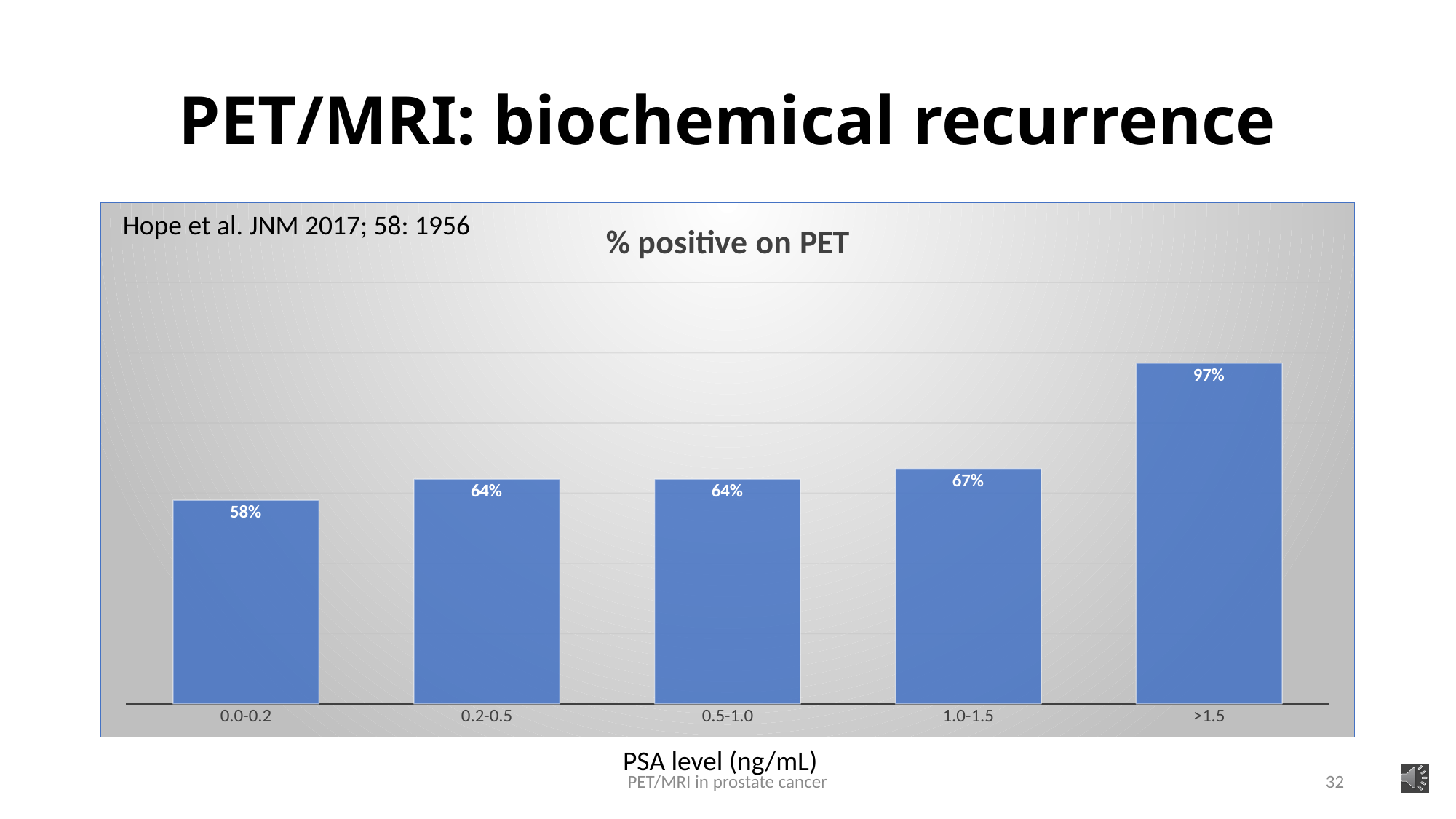
What is the % positive on PET for the PSA level 1.0-1.5 ng/mL? 67% Which PSA level category has the highest % positive on PET? >1.5 What is the difference in % positive on PET between the >1.5 and 0.0-0.2 PSA level categories? 39% Which has a higher % positive on PET: PSA level 1.0-1.5 or PSA level 0.0-0.2? 1.0-1.5 How many PSA level categories are shown in the chart? 5 What is the % positive on PET for the PSA level 0.2-0.5 ng/mL? 64% What is the % positive on PET for the PSA level 0.0-0.2 ng/mL? 58% What is the title of the chart? % positive on PET What is the % positive on PET for the PSA level >1.5 ng/mL? 97% What type of chart is shown on the slide? Bar chart Which PSA level category has the lowest % positive on PET? 0.0-0.2 What is the difference in % positive on PET between the 1.0-1.5 and 0.5-1.0 PSA level categories? 3%